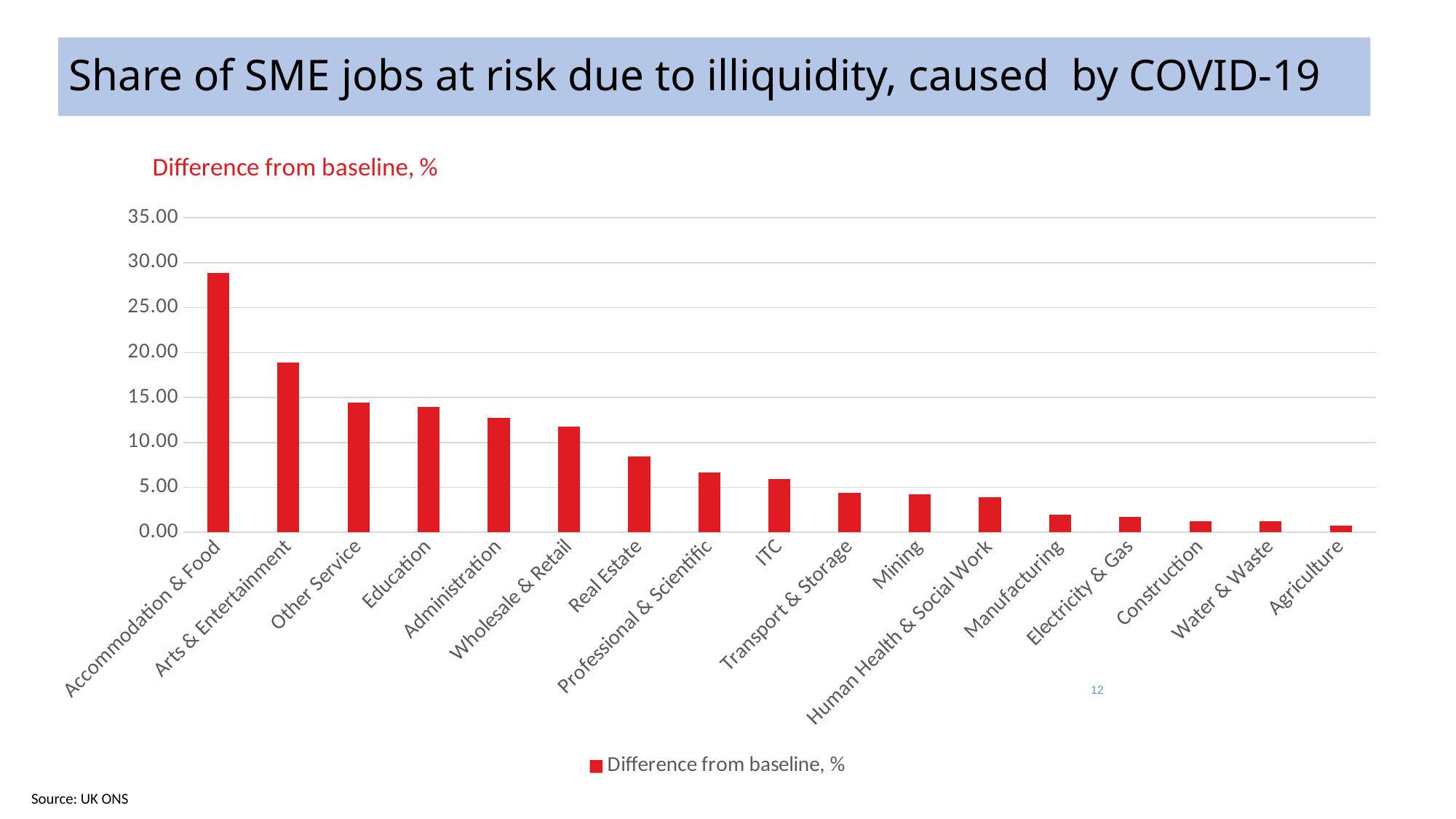
Do the values rise or fall moving from left to right along the x axis? Fall Which is larger, the value for Real Estate or the value for Mining? Real Estate Which sector has the lowest share of SME jobs at risk? Agriculture Is the value for Arts & Entertainment greater or less than 20.00? less Is the value for Transport & Storage greater or less than 5.00? less Which sector has the highest share of SME jobs at risk? Accommodation & Food What kind of chart is shown on the slide? Bar chart Is the value for Education greater or less than 10.00? greater How many sectors are plotted on the chart? 17 What is the name of the series shown in the legend? Difference from baseline, % How many series does the legend list? 1